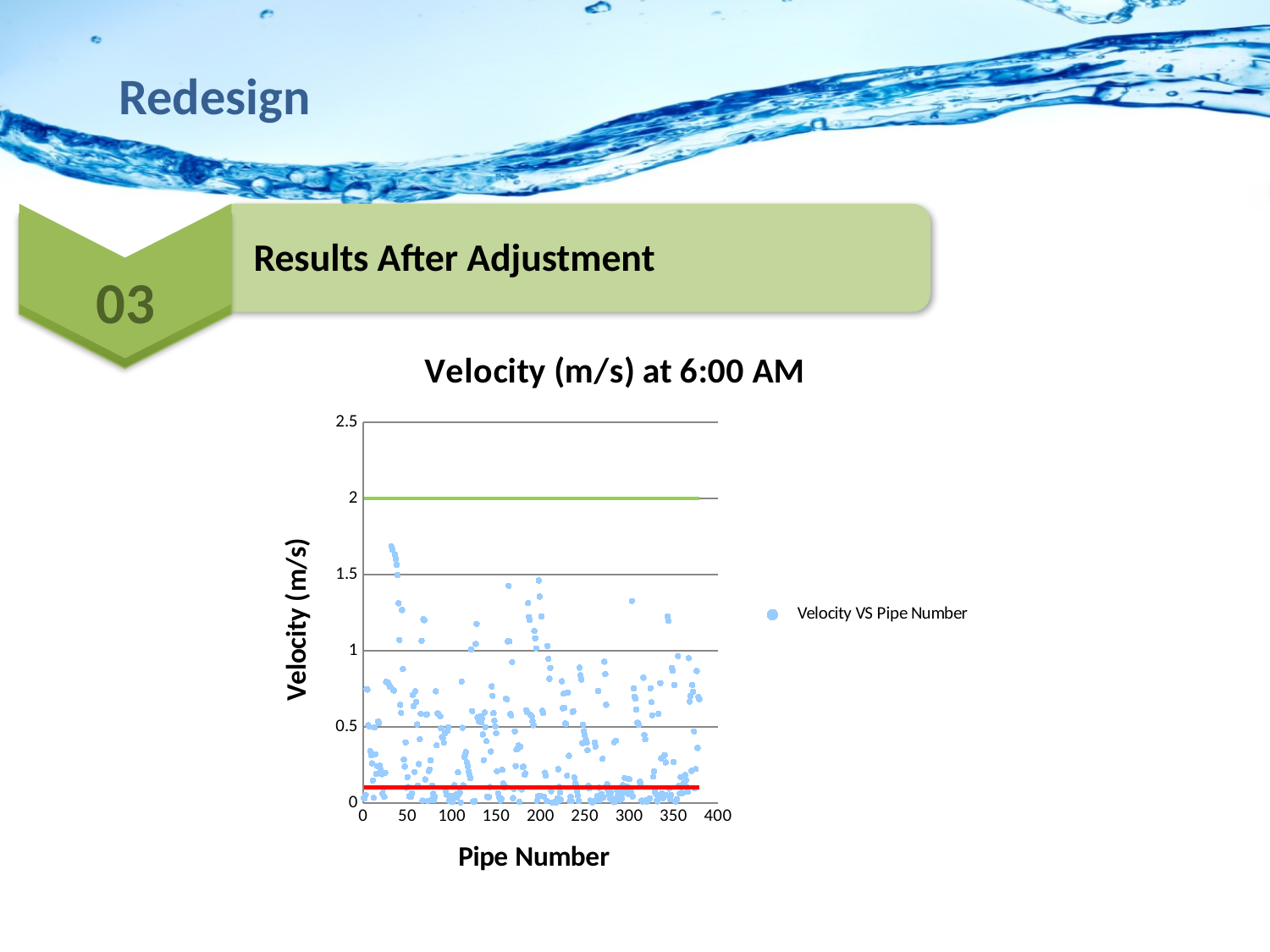
Is the highest plotted velocity greater or less than 1.5? greater What is the highest value shown on the y axis? 2.5 How many series does the chart legend list? 1 Is the red horizontal line drawn at a velocity greater or less than 0.5? less What is the highest value shown on the x axis? 400 Is the highest plotted velocity greater or less than 2? less What is the label of the x axis? Pipe Number What is the title of the chart? Velocity (m/s) at 6:00 AM What kind of chart is shown on the slide? scatter chart Is the green horizontal line above or below the red horizontal line? above At what velocity value is the green horizontal line drawn? 2 How many tick labels are shown on the x axis? 9